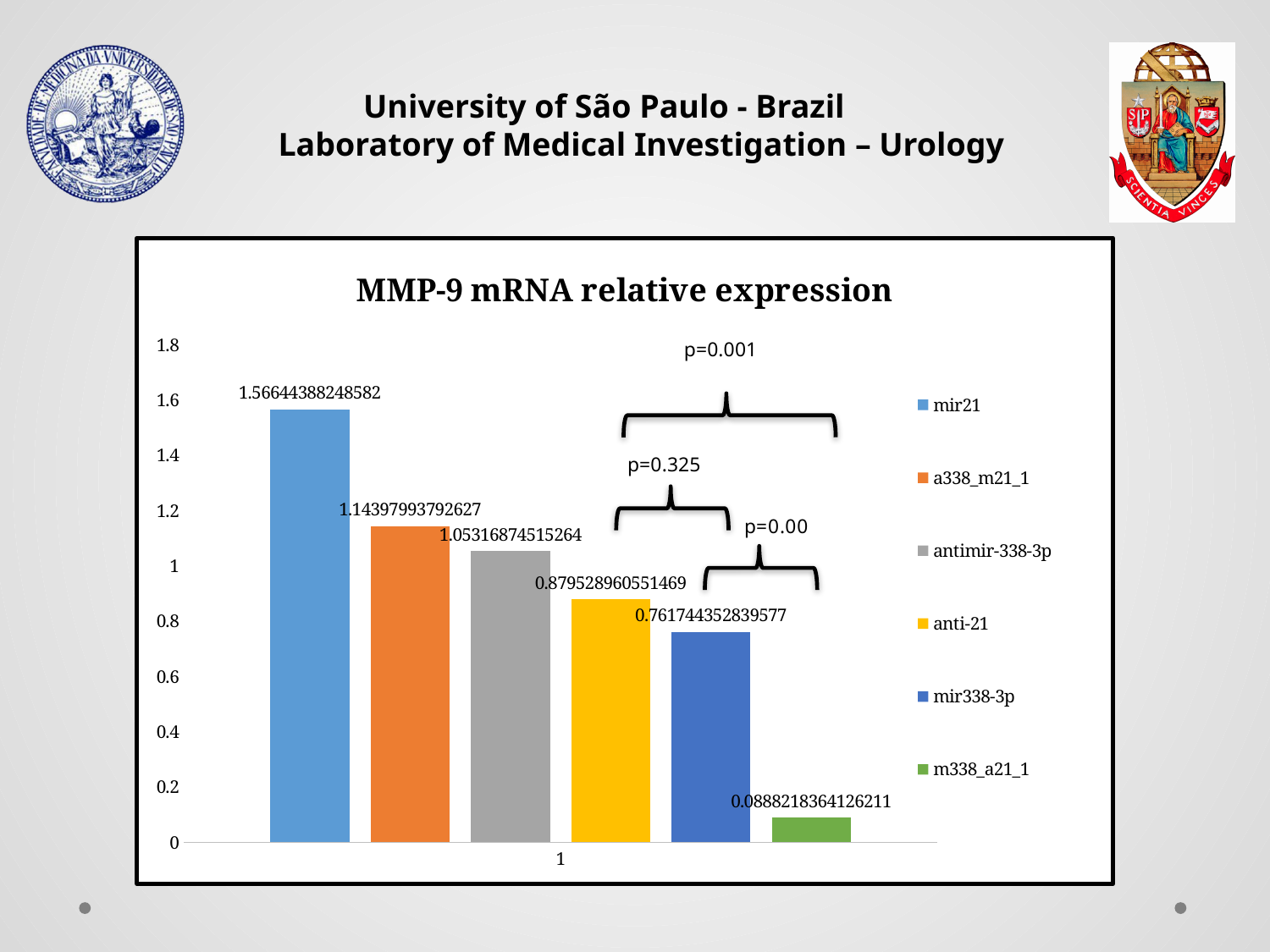
How many series does the legend list? 6 Which is larger, the value for anti-21 or the value for mir338-3p? anti-21 What is the value for antimir-338-3p? 1.05316874515264 Which series has the lowest value? m338_a21_1 What type of chart is shown on the slide? bar chart What is the value for a338_m21_1? 1.14397993792627 What is the value for mir21? 1.56644388248582 Which series has the highest value? mir21 What is the title of the chart? MMP-9 mRNA relative expression What is the value for m338_a21_1? 0.0888218364126211 What is the value for anti-21? 0.879528960551469 What is the value for mir338-3p? 0.761744352839577